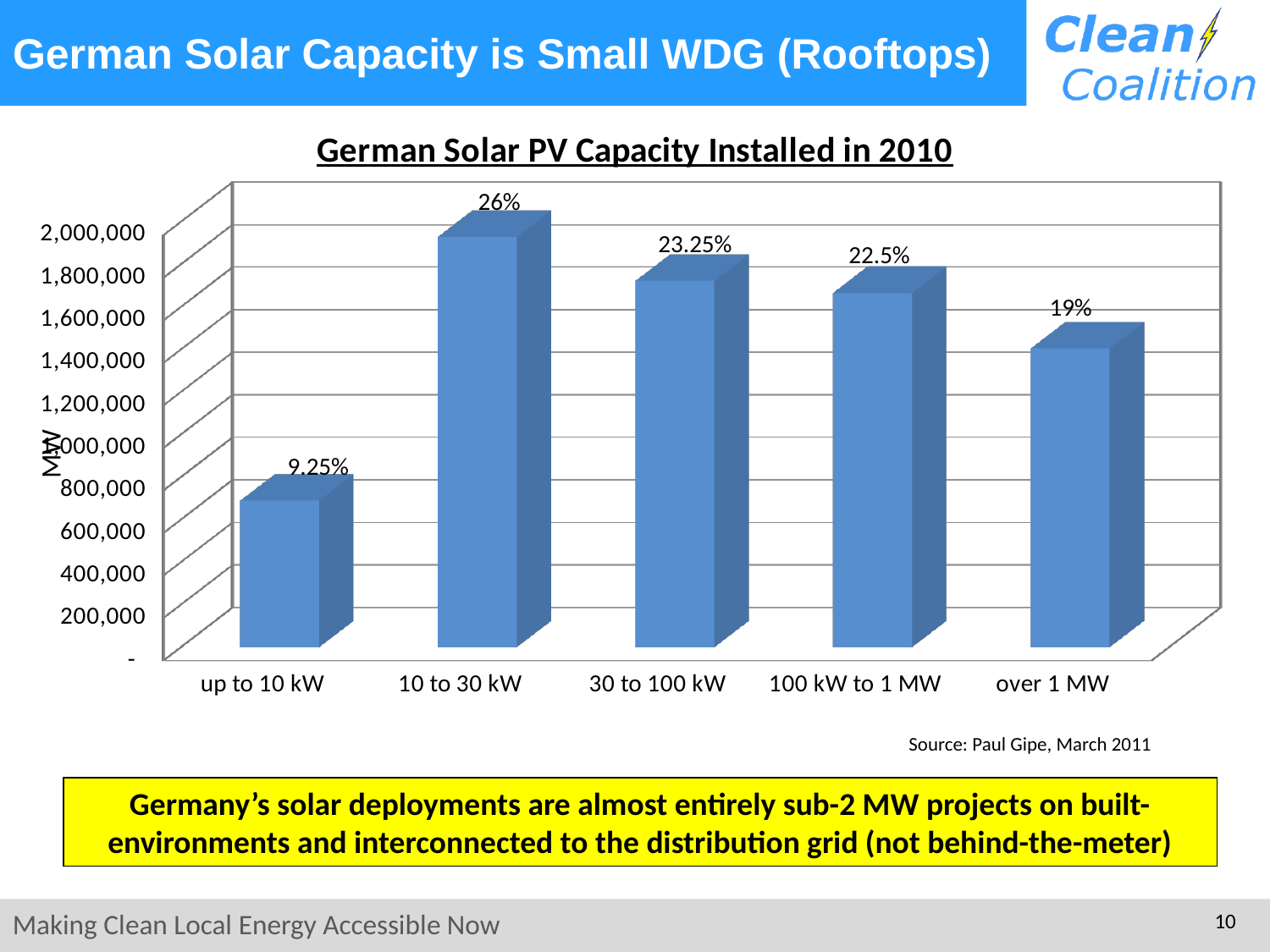
How many capacity categories are shown on the x axis of the chart? 5 What is the title of the chart? German Solar PV Capacity Installed in 2010 What percentage label is shown above the bar for '100 kW to 1 MW'? 22.5% What type of chart is shown on the slide? bar chart What percentage label is shown above the bar for '10 to 30 kW'? 26% What percentage label is shown above the bar for 'over 1 MW'? 19% Which capacity category has the lowest bar in the chart? up to 10 kW Which bar is taller: '10 to 30 kW' or 'over 1 MW'? 10 to 30 kW What percentage label is shown above the bar for '30 to 100 kW'? 23.25% What percentage label is shown above the bar for 'up to 10 kW'? 9.25% Which capacity category has the highest bar in the chart? 10 to 30 kW Is the value for 'up to 10 kW' greater or less than 1,000,000 MW? less